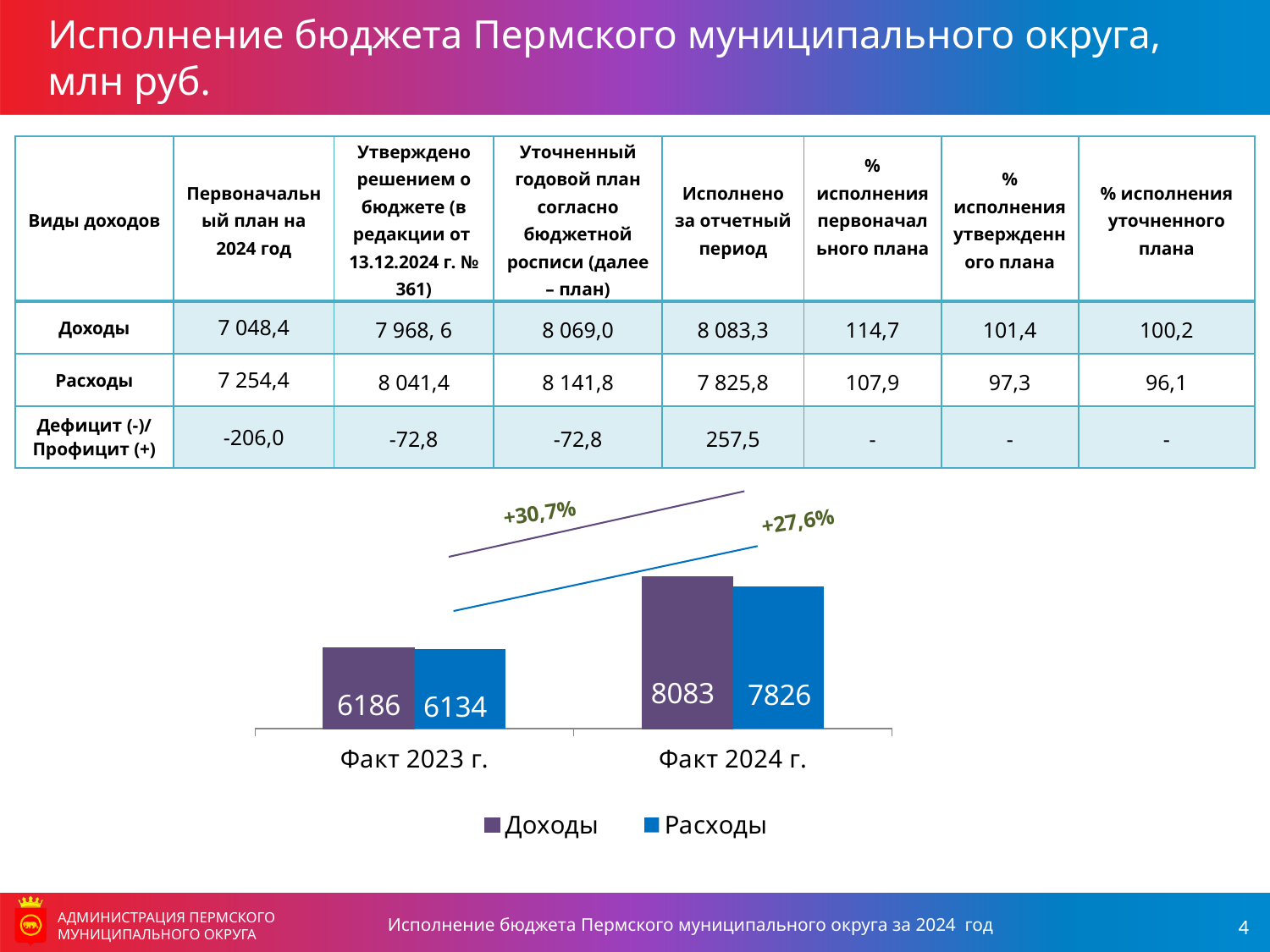
How many categories are shown on the x axis of the chart? 2 What is the value of Доходы for Факт 2023 г.? 6186 Do the Расходы values rise or fall from Факт 2023 г. to Факт 2024 г.? rise What percentage growth is annotated above the Доходы bars in the chart? +30,7% What is the value of Расходы for Факт 2023 г.? 6134 What is the value of Расходы for Факт 2024 г.? 7826 What is the difference between Доходы and Расходы for Факт 2024 г.? 257 What is the value of Доходы for Факт 2024 г.? 8083 What type of chart is shown on the slide? bar chart Which is larger for Факт 2024 г.: Доходы or Расходы? Доходы How many series does the chart legend list? 2 What is the difference between Доходы for Факт 2024 г. and Доходы for Факт 2023 г.? 1897